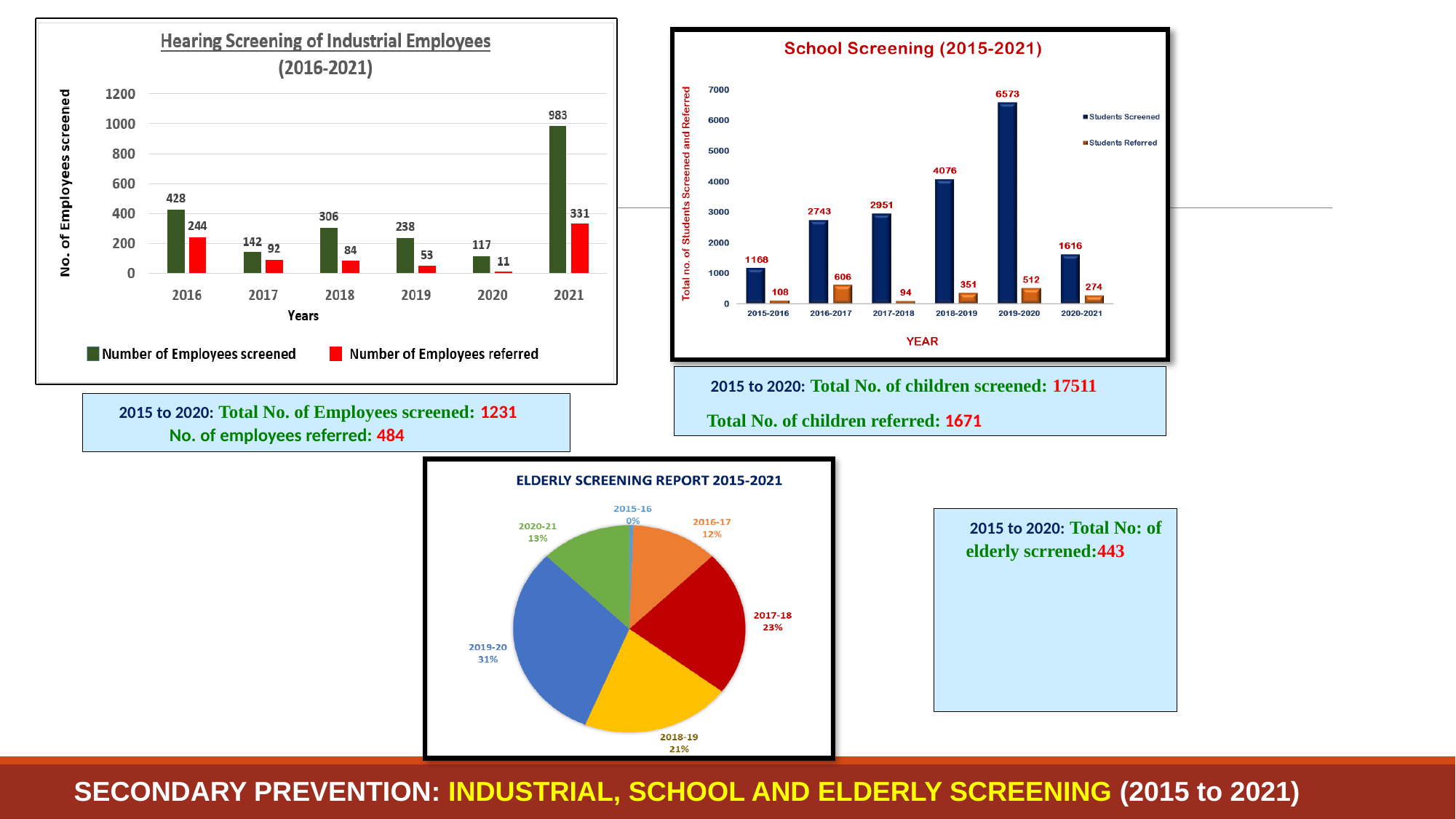
In the 'ELDERLY SCREENING REPORT 2015-2021' pie chart, which year has the largest slice? 2019-20 In the 'ELDERLY SCREENING REPORT 2015-2021' pie chart, what share does 2019-20 have? 31% In the 'School Screening (2015-2021)' chart, which year has the highest number of students referred? 2016-2017 In the 'Hearing Screening of Industrial Employees (2016-2021)' chart, how many employees were screened in 2021? 983 In the 'Hearing Screening of Industrial Employees (2016-2021)' chart, what is the difference between the number of employees screened and referred in 2016? 184 In the 'School Screening (2015-2021)' chart, were more students screened in 2017-2018 or in 2018-2019? 2018-2019 In the 'Hearing Screening of Industrial Employees (2016-2021)' chart, how many series does the legend list? 2 What kind of chart is the 'ELDERLY SCREENING REPORT 2015-2021'? Pie chart In the 'Hearing Screening of Industrial Employees (2016-2021)' chart, which year has the lowest number of employees referred? 2020 In the 'School Screening (2015-2021)' chart, how many year categories are shown on the x axis? 6 In the 'School Screening (2015-2021)' chart, what is the difference between students screened in 2019-2020 and 2020-2021? 4957 In the 'School Screening (2015-2021)' chart, how many students were screened in 2019-2020? 6573